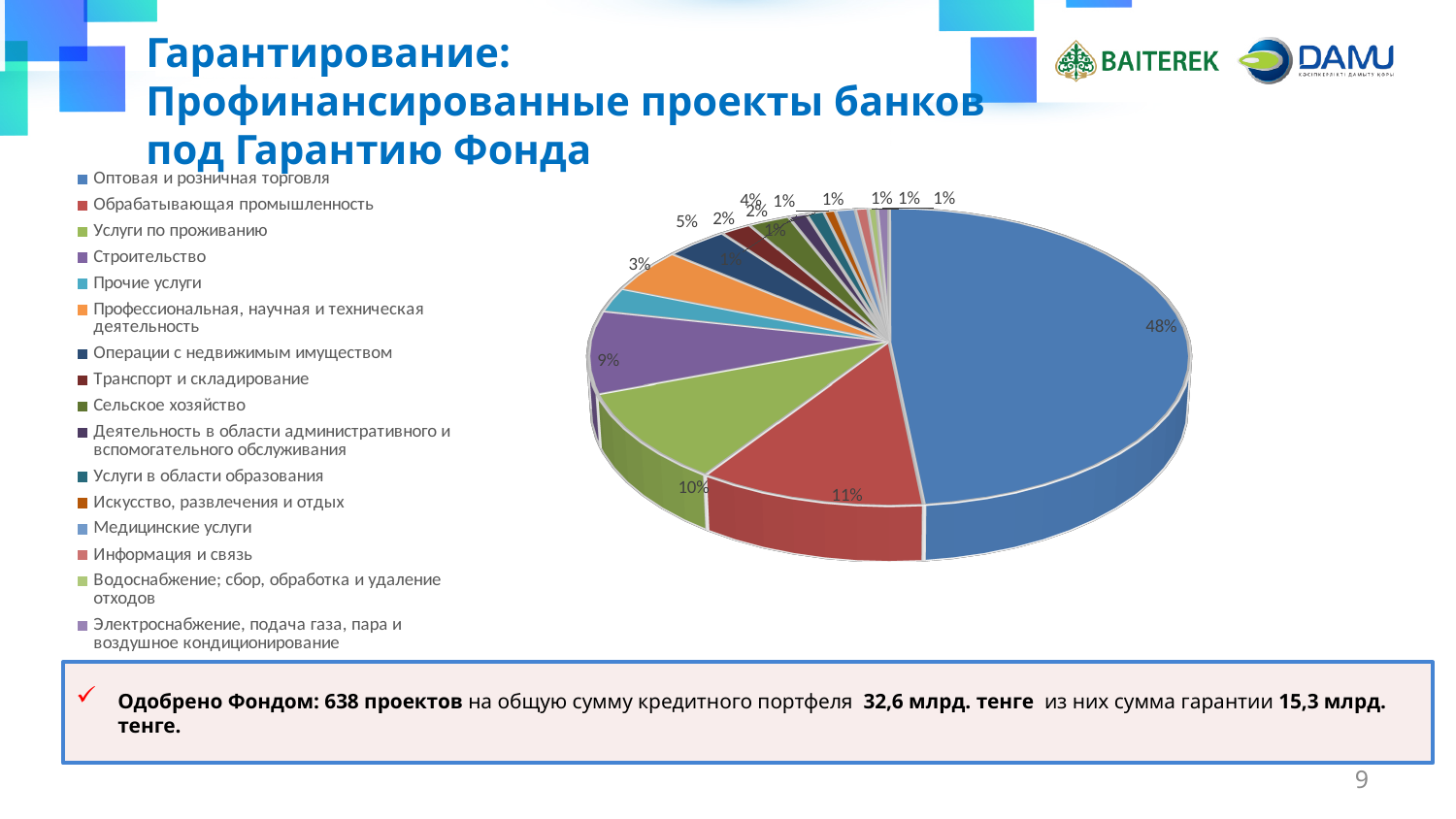
What share of the pie does Обрабатывающая промышленность have? 11% What share of the pie does Услуги по проживанию have? 10% Which category has the largest share of the pie? Оптовая и розничная торговля What share of the pie does Оптовая и розничная торговля have? 48% What is the difference in percentage points between Оптовая и розничная торговля and Обрабатывающая промышленность? 37 percentage points How many categories does the legend list? 16 What share of the pie does Профессиональная, научная и техническая деятельность have? 5% What colour is the slice for Обрабатывающая промышленность? Red What share of the pie does Прочие услуги have? 3% What share of the pie does Строительство have? 9% What type of chart is shown on the slide? Pie chart Which has a larger share: Строительство or Услуги по проживанию? Услуги по проживанию